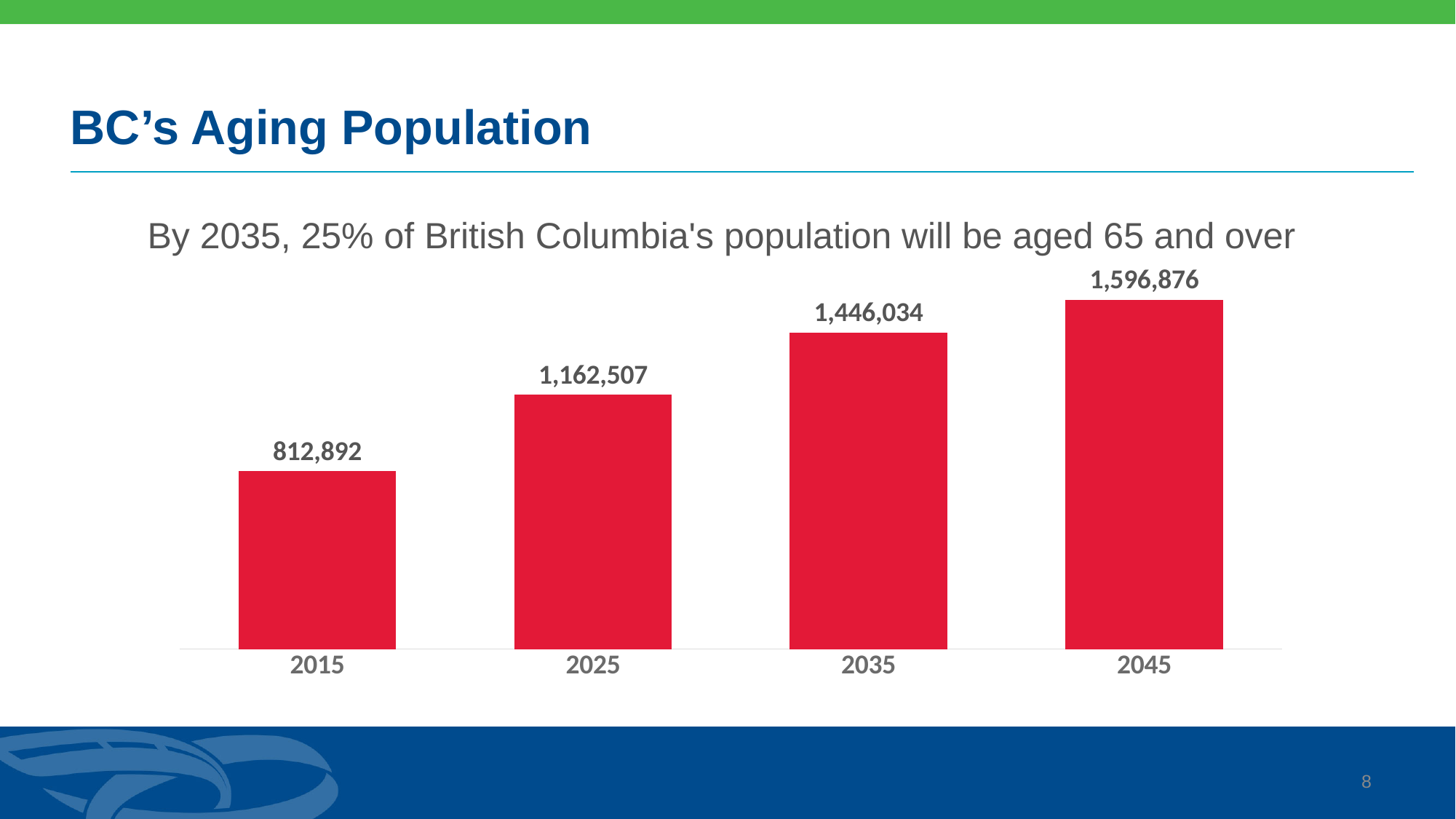
Which year has the lowest value? 2015 What kind of chart is shown on the slide? Bar chart Which is larger, the value for 2025 or the value for 2035? 2035 What is the value shown for 2045? 1,596,876 Which year has the highest value? 2045 How many years are shown on the chart? 4 What is the difference between the values for 2035 and 2025? 283,527 What is the difference between the values for 2045 and 2015? 783,984 What is the value shown for 2025? 1,162,507 Do the values rise or fall from 2015 to 2045? Rise What is the value shown for 2035? 1,446,034 What is the value shown for 2015? 812,892